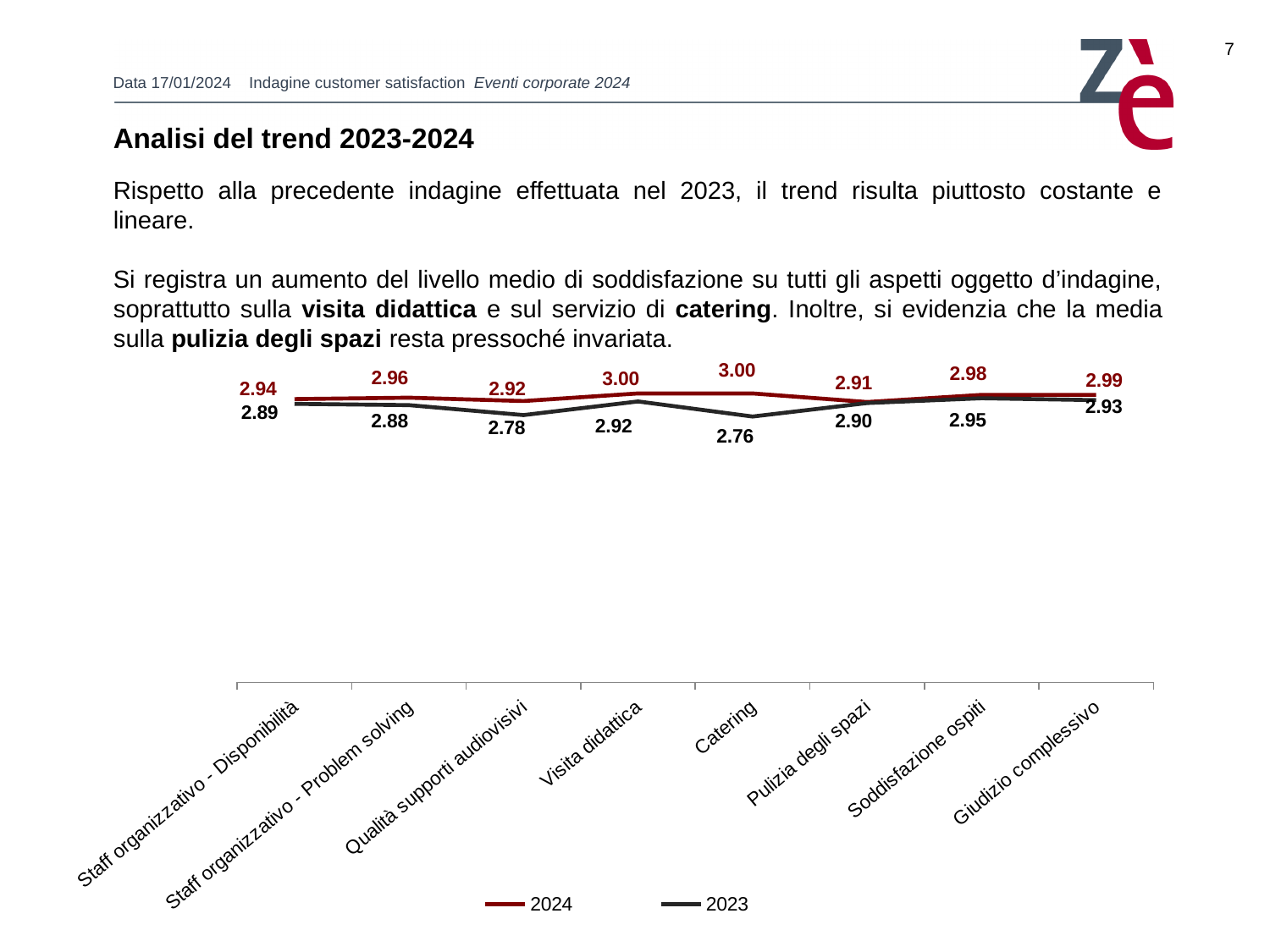
What is the 2024 value for Catering? 3.00 Which category has the highest 2023 value? Soddisfazione ospiti How many series does the legend list? 2 Which category has the lowest 2023 value? Catering Which category has the lowest 2024 value? Pulizia degli spazi How many categories are plotted along the x axis? 8 Which is larger for Visita didattica, the 2024 value or the 2023 value? 2024 What is the 2023 value for Qualità supporti audiovisivi? 2.78 Which series is drawn in red in the legend? 2024 What type of chart is shown on the slide? line chart What is the difference between the 2024 and 2023 values for Catering? 0.24 What is the 2024 value for Giudizio complessivo? 2.99